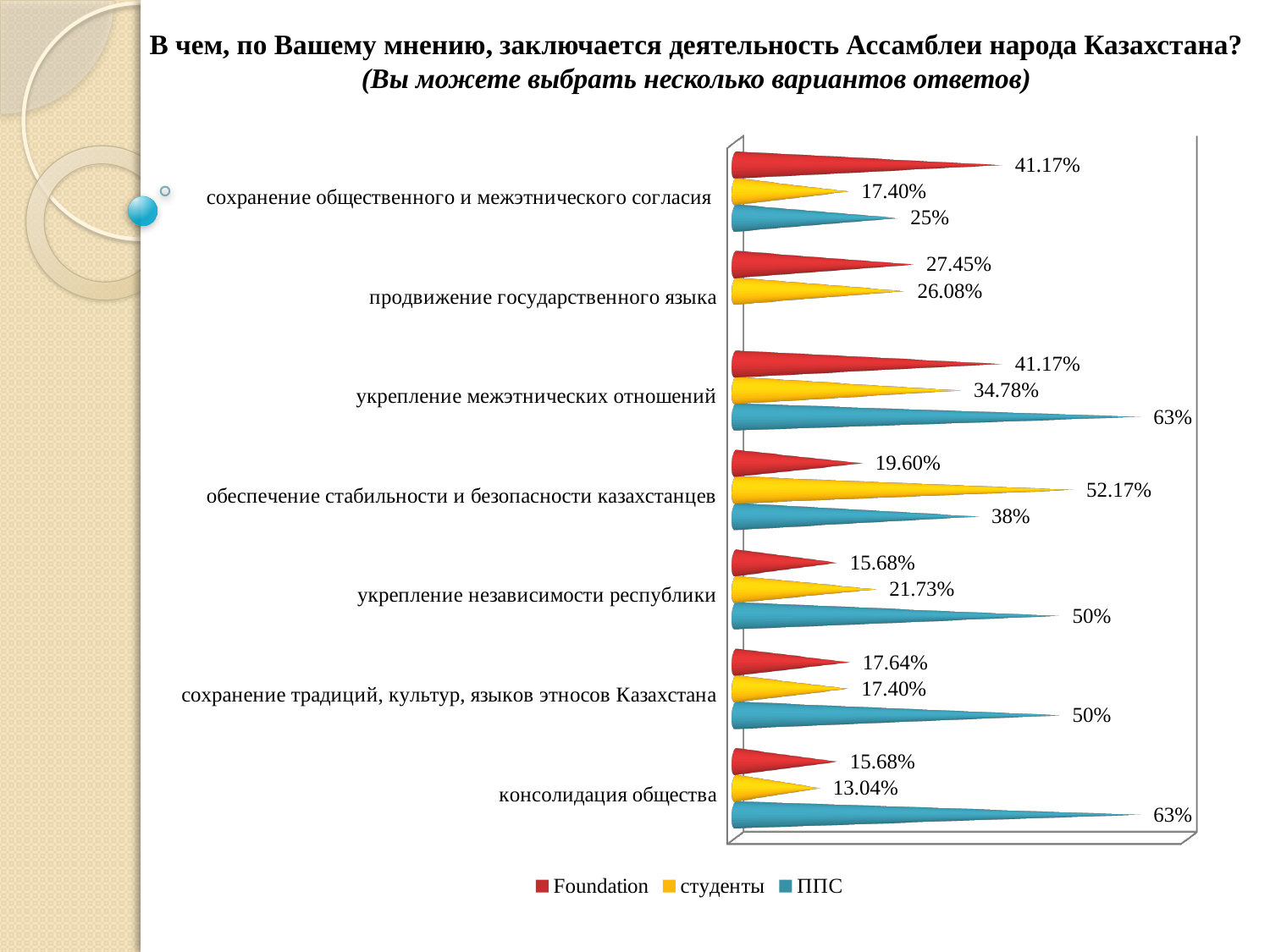
Which category has the lowest студенты value? консолидация общества How many categories are shown on the chart? 7 What is the студенты value for 'обеспечение стабильности и безопасности казахстанцев'? 52.17% What is the Foundation value for 'сохранение общественного и межэтнического согласия'? 41.17% What is the ППС value for 'консолидация общества'? 63% What type of chart is shown on the slide? bar chart Which category has the highest студенты value? обеспечение стабильности и безопасности казахстанцев What is the difference between the ППС and Foundation values for 'укрепление межэтнических отношений'? 21.83% For 'укрепление независимости республики', which is larger: the Foundation value or the студенты value? студенты How many series does the legend list? 3 Which series is shown in blue in the legend? ППС What is the студенты value for 'продвижение государственного языка'? 26.08%